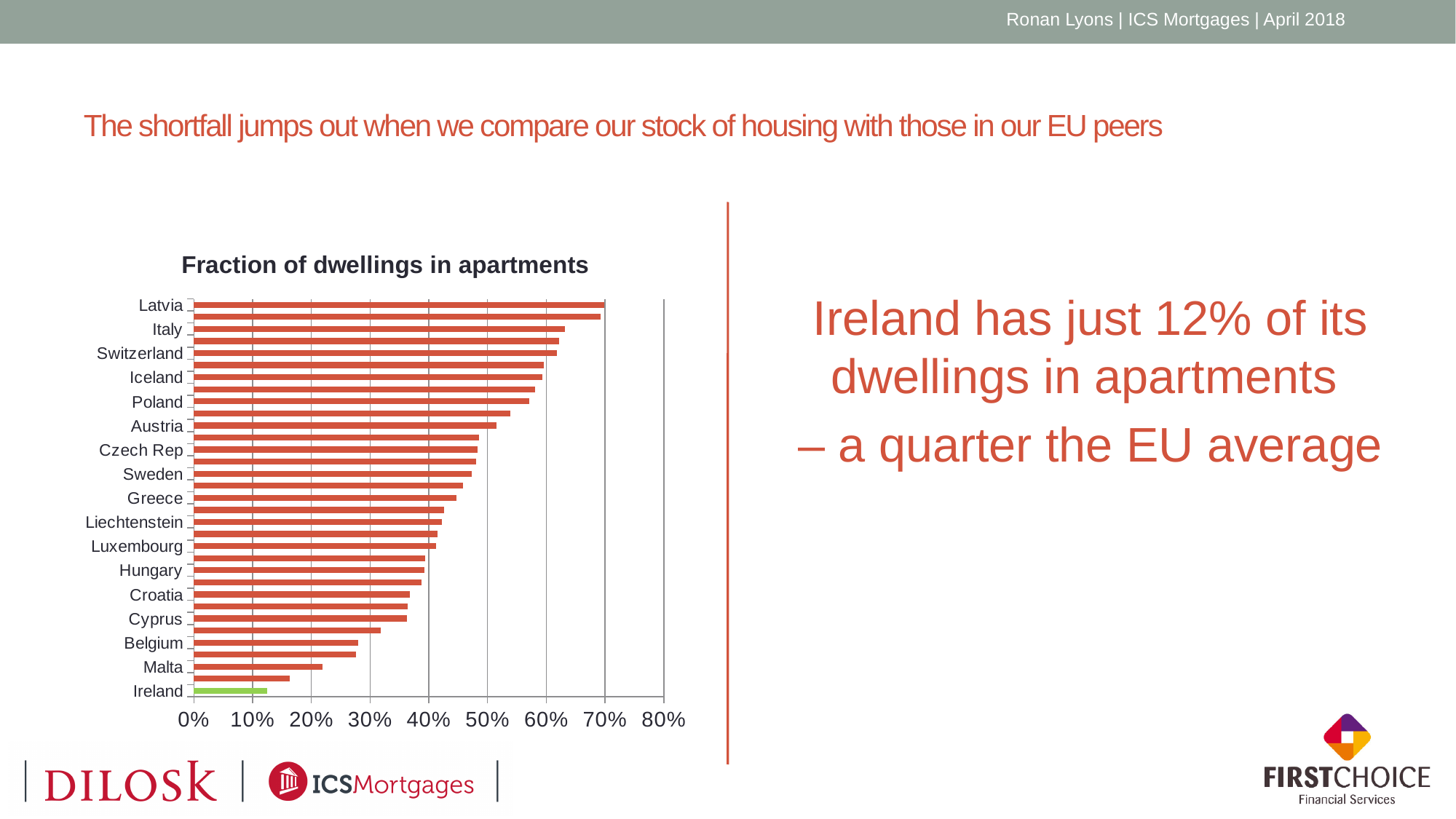
What fraction of Ireland's dwellings are in apartments? 12% What colour is the bar for Ireland, which differs from the other bars? Green What is the title of the chart? Fraction of dwellings in apartments Which has a larger fraction of dwellings in apartments, Italy or Malta? Italy Which has a larger fraction of dwellings in apartments, Belgium or Switzerland? Switzerland Is the value for Cyprus greater or less than 40%? less Is the value for Latvia greater or less than 60%? greater Which country has the highest fraction of dwellings in apartments? Latvia Is the value for Malta greater or less than 30%? less Which country has the lowest fraction of dwellings in apartments? Ireland What kind of chart is shown on the slide? Bar chart